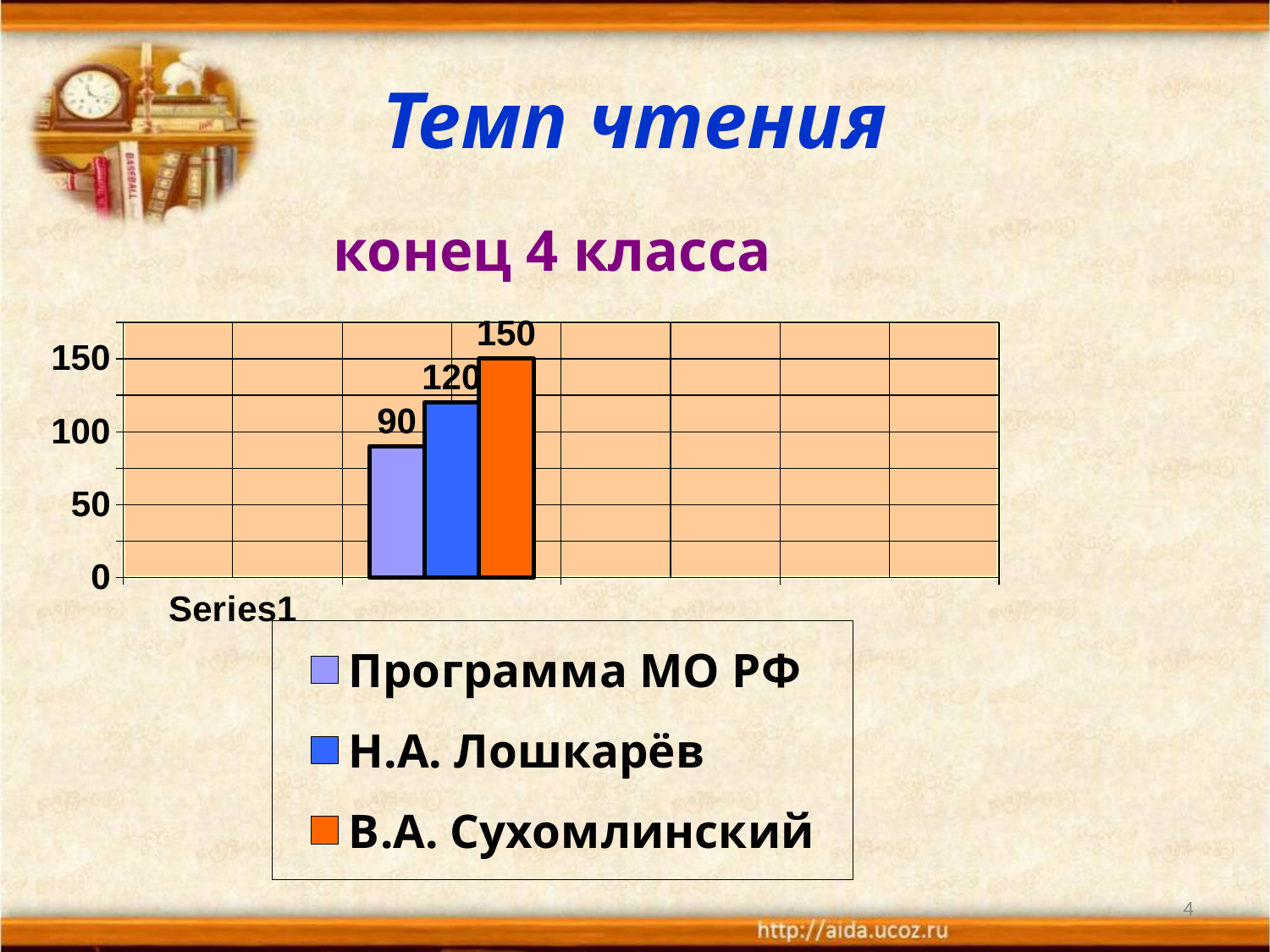
Which is larger, the value for Н.А. Лошкарёв or the value for Программа МО РФ? Н.А. Лошкарёв What kind of chart is shown on the slide? bar chart Is the value for Н.А. Лошкарёв greater or less than 100? greater What is the difference between the values for В.А. Сухомлинский and Программа МО РФ? 60 What is the value for Программа МО РФ? 90 How many series does the legend list? 3 What is the difference between the values for Н.А. Лошкарёв and Программа МО РФ? 30 What is the value for В.А. Сухомлинский? 150 What is the value for Н.А. Лошкарёв? 120 Which series has the highest value? В.А. Сухомлинский What colour is the bar for В.А. Сухомлинский? orange Which series has the lowest value? Программа МО РФ